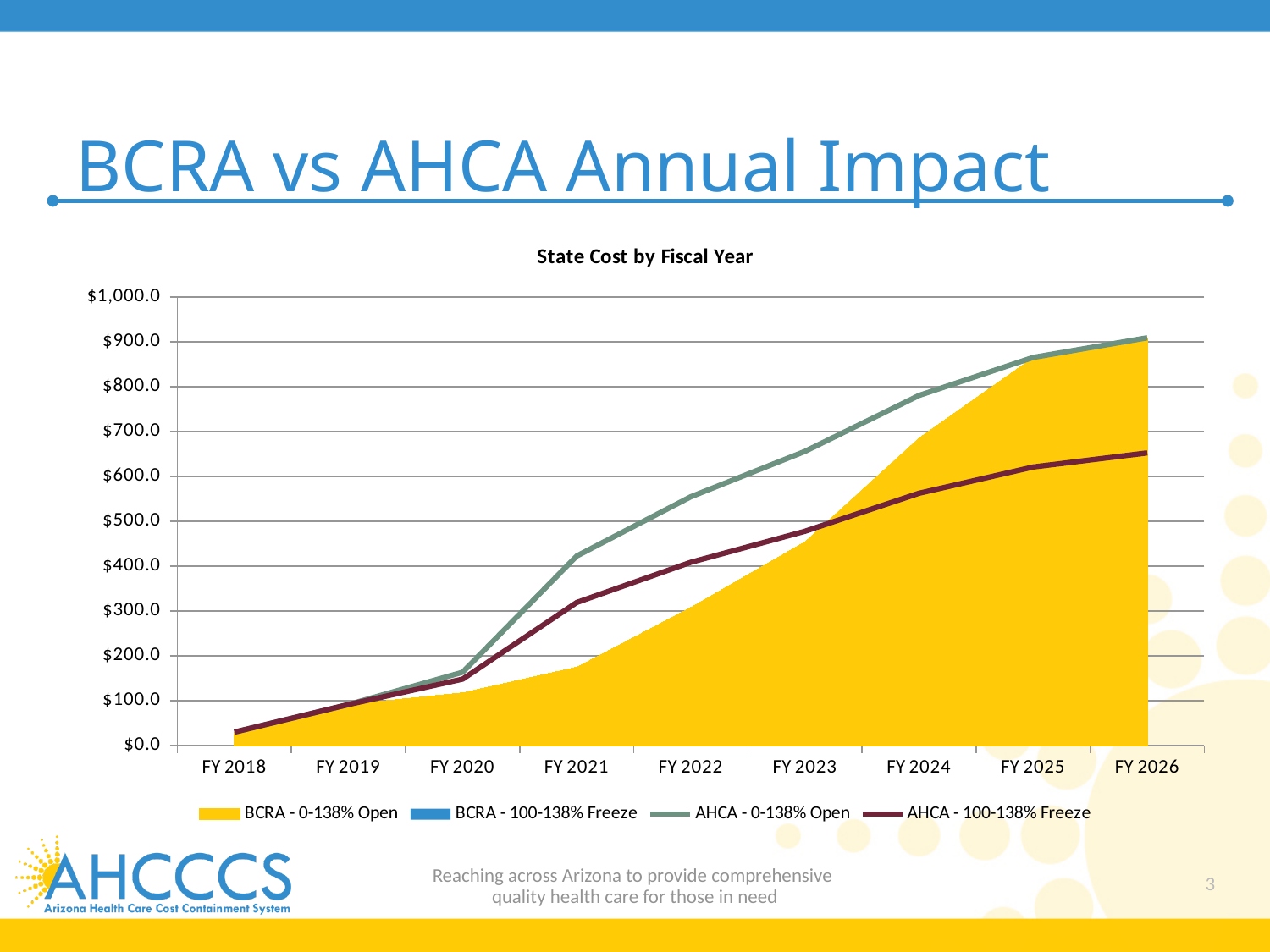
Does the AHCA - 0-138% Open series rise or fall from FY 2018 to FY 2026? Rise In FY 2021, which is larger: AHCA - 0-138% Open or AHCA - 100-138% Freeze? AHCA - 0-138% Open Is the BCRA - 0-138% Open value for FY 2023 greater or less than $500.0? less What colour is the BCRA - 0-138% Open series? Yellow Is the AHCA - 0-138% Open value for FY 2021 greater or less than $400.0? greater What is the title of the chart? State Cost by Fiscal Year How many fiscal years are shown on the x axis? 9 Is the AHCA - 100-138% Freeze value for FY 2026 greater or less than $600.0? greater In which fiscal year is the AHCA - 100-138% Freeze value lowest? FY 2018 How many series does the chart legend list? 4 In which fiscal year is the AHCA - 0-138% Open value highest? FY 2026 In FY 2024, which is larger: BCRA - 0-138% Open or AHCA - 100-138% Freeze? BCRA - 0-138% Open